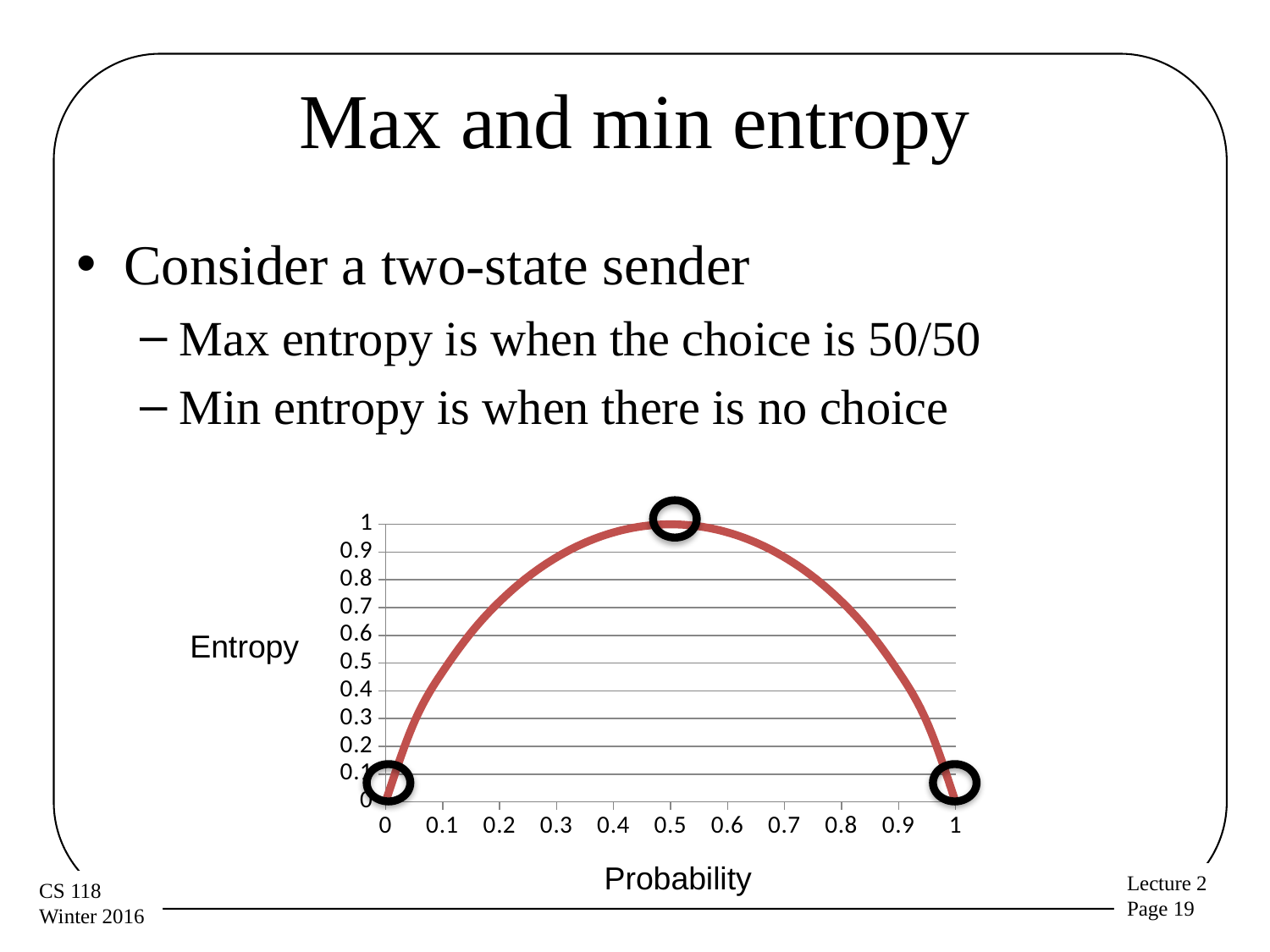
What is the label of the x axis of the chart? Probability What is the label of the y axis of the chart? Entropy At which probability does the entropy curve reach its highest value? 0.5 Is the entropy at probability 0.1 greater or less than 0.3? greater What is the entropy value when the probability is 1? 0 What is the entropy value when the probability is 0.5? 1 Does the entropy rise or fall as probability increases from 0.5 to 1? fall Does the entropy rise or fall as probability increases from 0 to 0.5? rise Is the entropy at probability 0.9 greater or less than 0.6? less What kind of chart is shown on the slide? line chart Is the entropy at probability 0.3 greater or less than 0.8? greater What is the entropy value when the probability is 0? 0